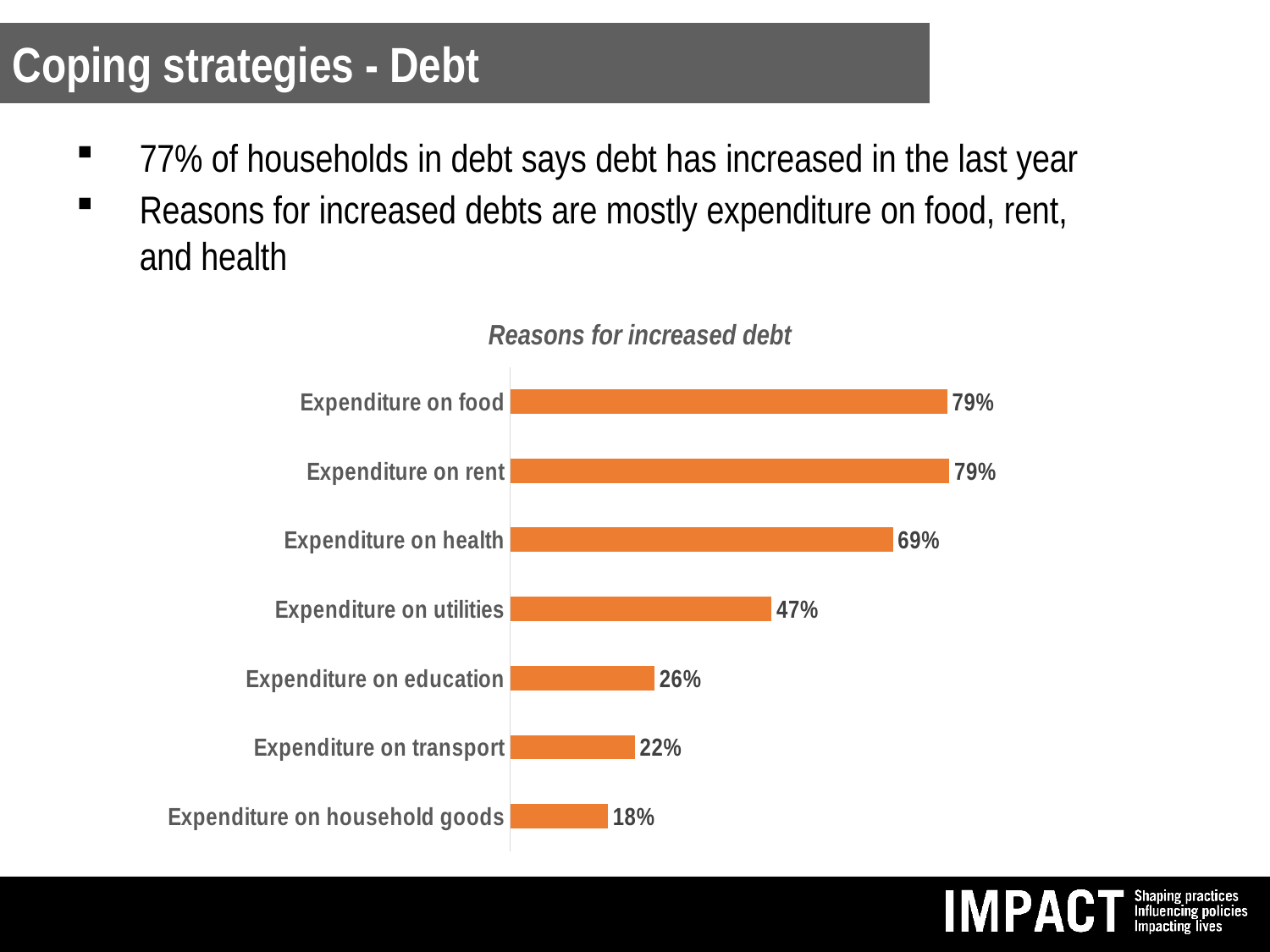
What is the difference between Expenditure on health and Expenditure on utilities? 22% What is the title of the chart? Reasons for increased debt How many categories are shown in the chart? 7 What is the value for Expenditure on transport? 22% What kind of chart is shown? Bar chart What is the difference between Expenditure on education and Expenditure on transport? 4% Which is larger, Expenditure on utilities or Expenditure on education? Expenditure on utilities What is the value for Expenditure on household goods? 18% What is the value for Expenditure on health? 69% What colour are the bars in the chart? Orange What is the value for Expenditure on utilities? 47% Which category has the lowest value? Expenditure on household goods